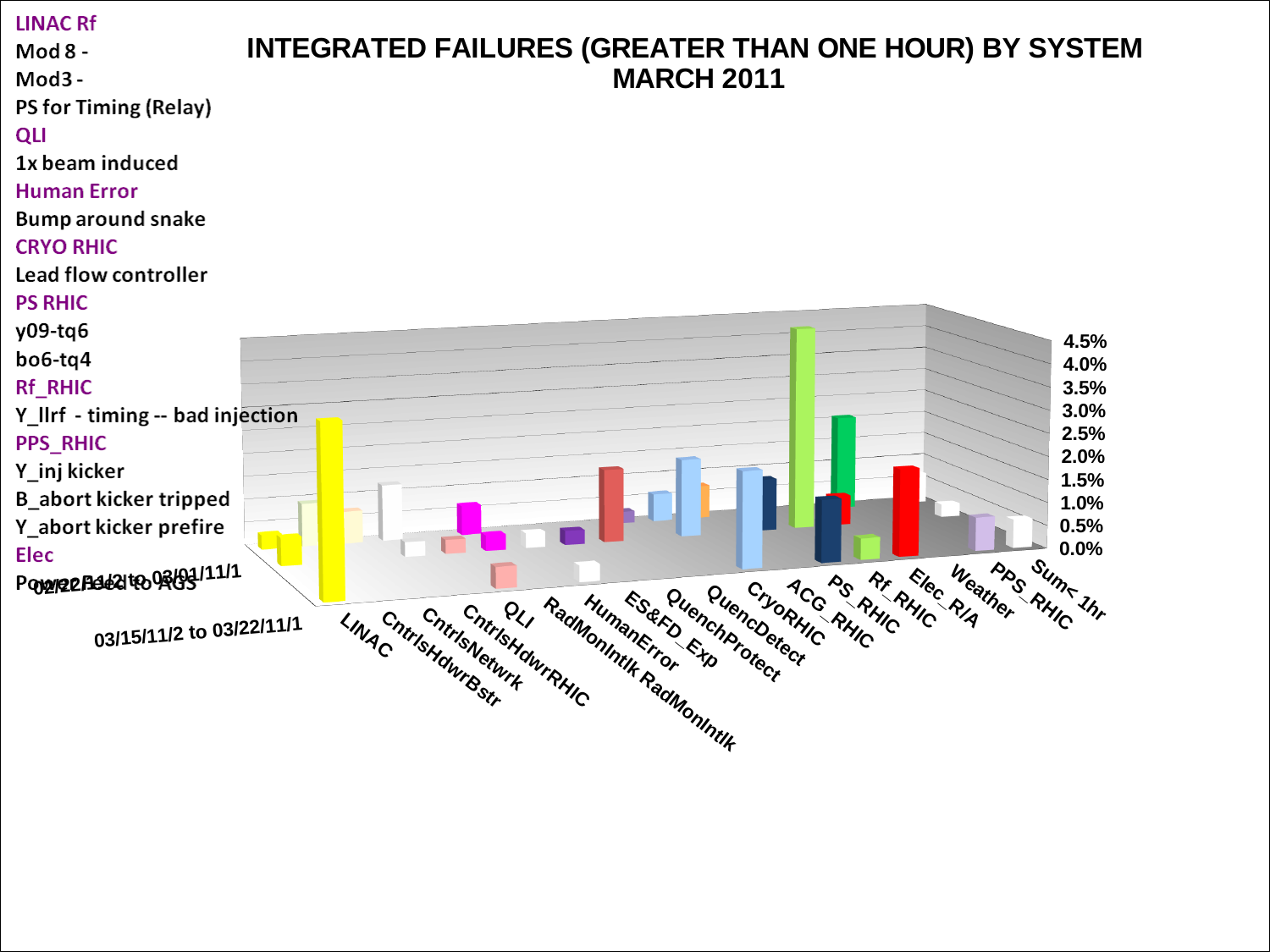
What is the highest value shown on the vertical axis of the chart? 4.5% What kind of chart is shown on the slide? bar chart Which has a taller bar in the chart, LINAC or CntrlsNetwrk? LINAC Which system category has the tallest bar in the chart? Rf_RHIC How many system categories are listed along the x axis of the chart? 18 Is the tallest bar for QLI greater or less than 2.5%? less Is the tallest bar for CryoRHIC greater or less than 3.0%? less What is the title of the chart? INTEGRATED FAILURES (GREATER THAN ONE HOUR) BY SYSTEM MARCH 2011